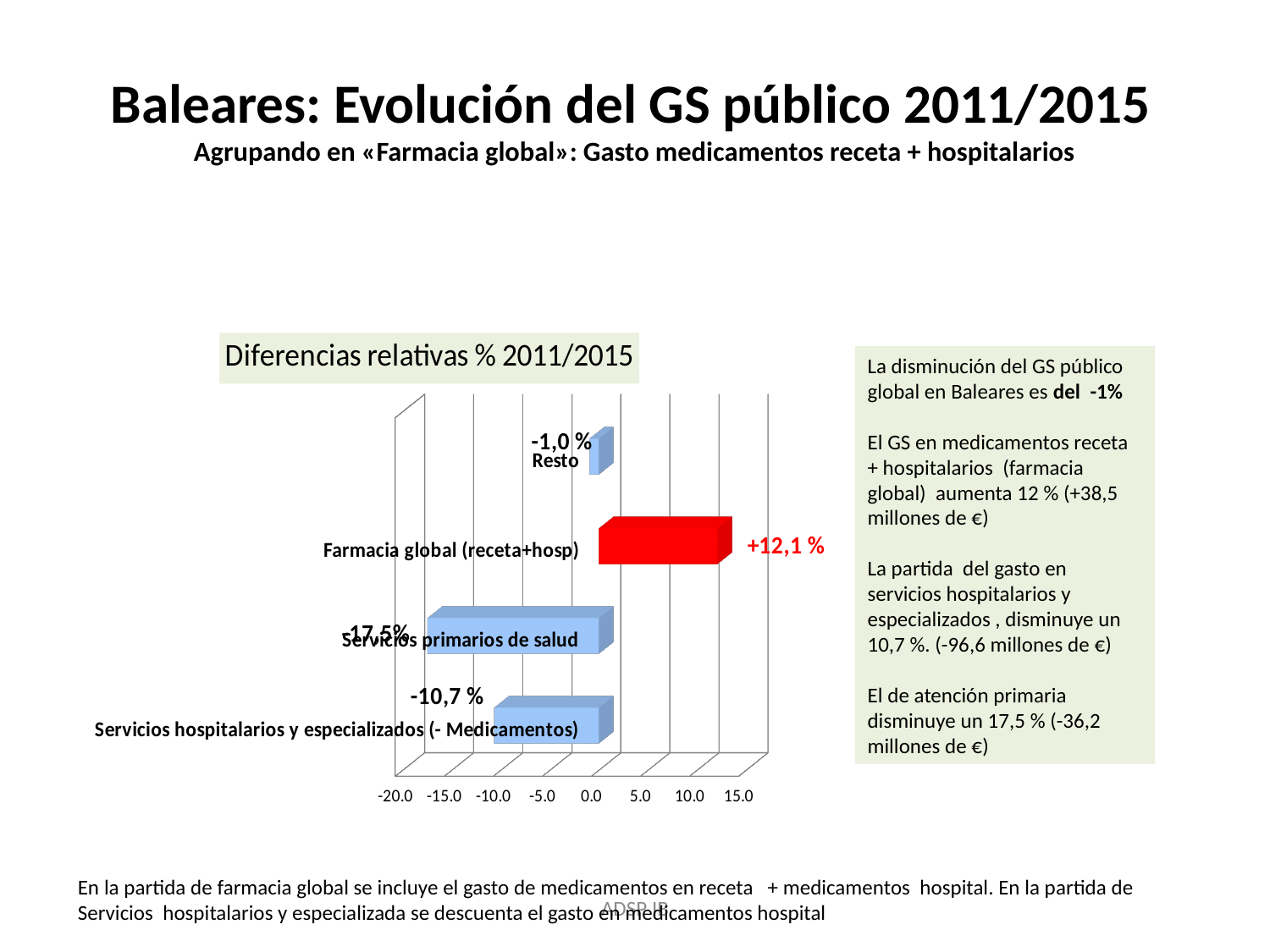
Is the value for Farmacia global (receta+hosp) greater or less than 10.0? greater How many categories are plotted in the chart? 4 What is the title of the chart? Diferencias relativas % 2011/2015 What is the value shown for Farmacia global (receta+hosp)? +12,1 % Which has a larger value: Resto or Servicios hospitalarios y especializados (- Medicamentos)? Resto What type of chart is shown on the slide? bar chart What is the value shown for Servicios primarios de salud? -17,5% What is the value shown for Resto? -1,0 % Which category has the lowest value in the chart? Servicios primarios de salud What colour is the bar for Farmacia global (receta+hosp)? red Which category has the highest value in the chart? Farmacia global (receta+hosp) What is the value shown for Servicios hospitalarios y especializados (- Medicamentos)? -10,7 %